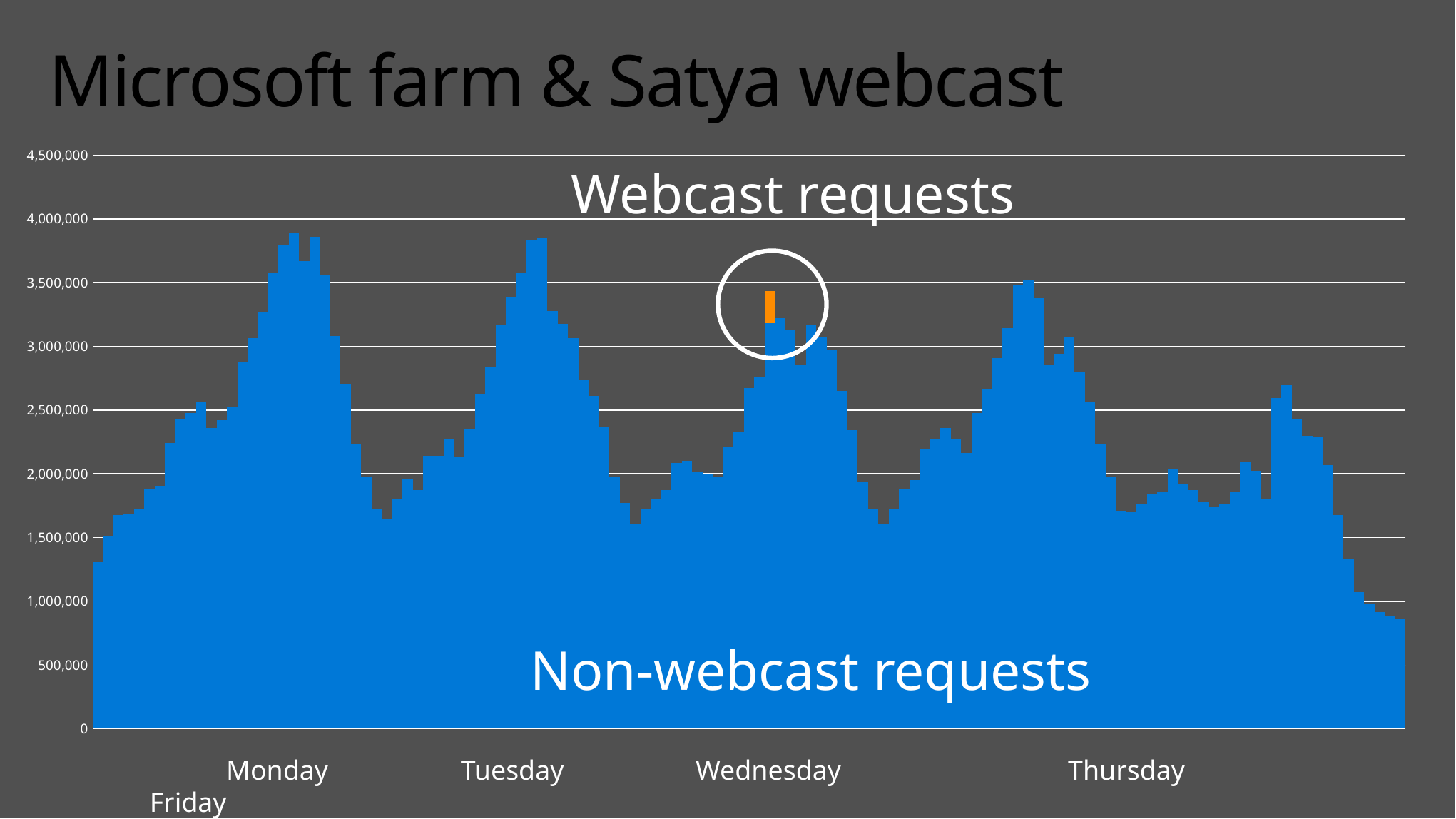
What colour represents the webcast requests in the chart? orange How many day labels are shown along the x axis? 5 Is the highest value on Thursday greater or less than 4,000,000? less Which day has the higher peak, Monday or Thursday? Monday Is the highest value on Monday greater or less than 3,500,000? greater Is the value of the last bar at the far right of the chart greater or less than 1,000,000? less Do the values rise or fall from the Thursday peak to the right end of the chart? fall What is the title of the chart on the slide? Microsoft farm & Satya webcast What kind of chart is shown on the slide? bar chart On which day does the orange webcast requests segment appear? Wednesday What is the highest value shown on the y axis? 4,500,000